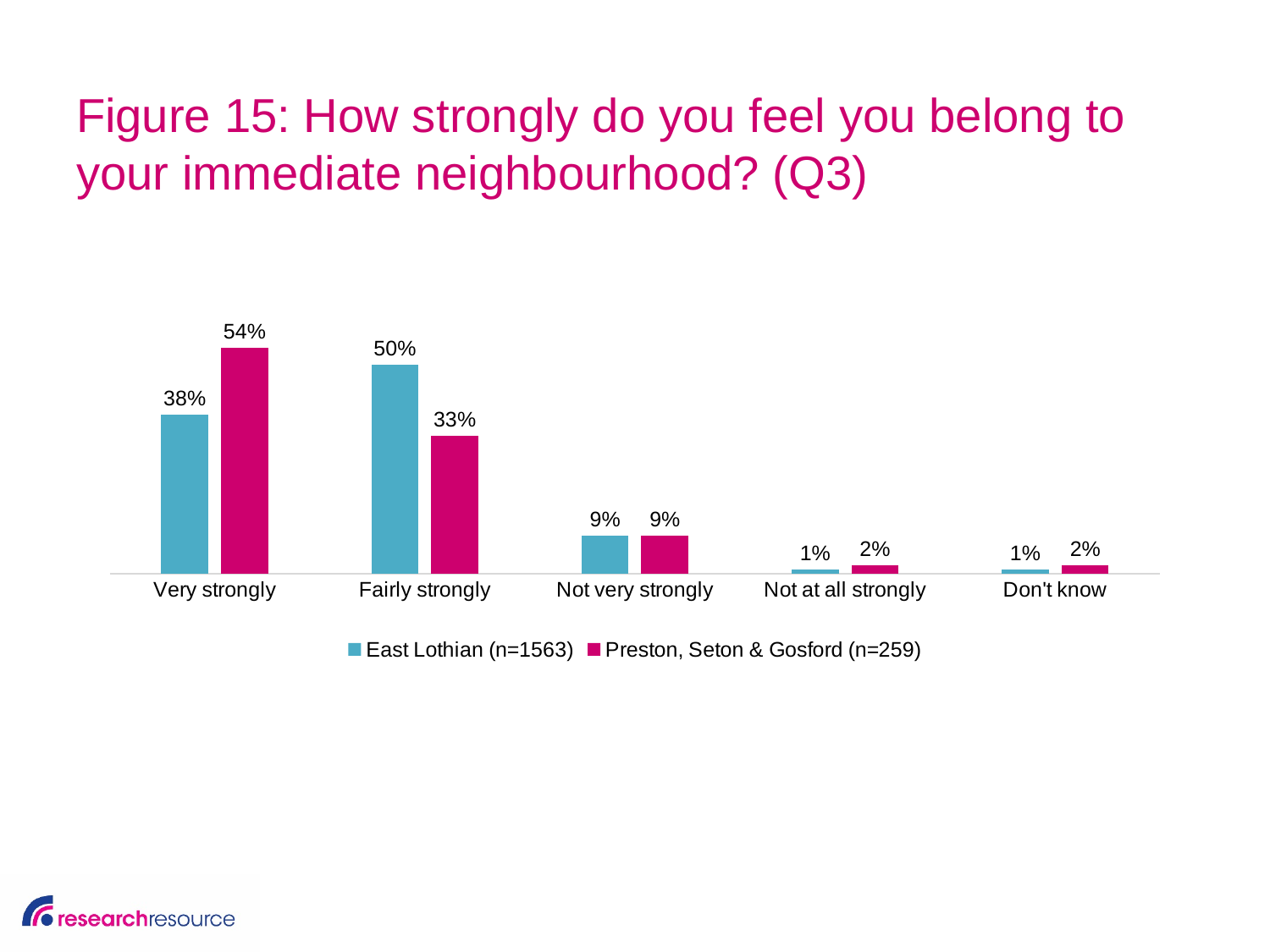
For 'Fairly strongly', which series has the larger value: East Lothian or Preston, Seton & Gosford? East Lothian How many series does the legend list? 2 What percentage of Preston, Seton & Gosford respondents said 'Fairly strongly'? 33% What percentage of East Lothian respondents said they feel they belong 'Very strongly' to their immediate neighbourhood? 38% What is the difference between the Preston, Seton & Gosford and East Lothian values for 'Very strongly'? 16% What is the sample size (n) for the East Lothian series shown in the legend? 1563 How many response categories are shown on the x axis? 5 What is the difference between the East Lothian and Preston, Seton & Gosford values for 'Fairly strongly'? 17% Which category has the highest value for East Lothian? Fairly strongly What is the value for Preston, Seton & Gosford in the 'Not at all strongly' category? 2% What kind of chart is shown on the slide? Bar chart Which category has the highest value for Preston, Seton & Gosford? Very strongly